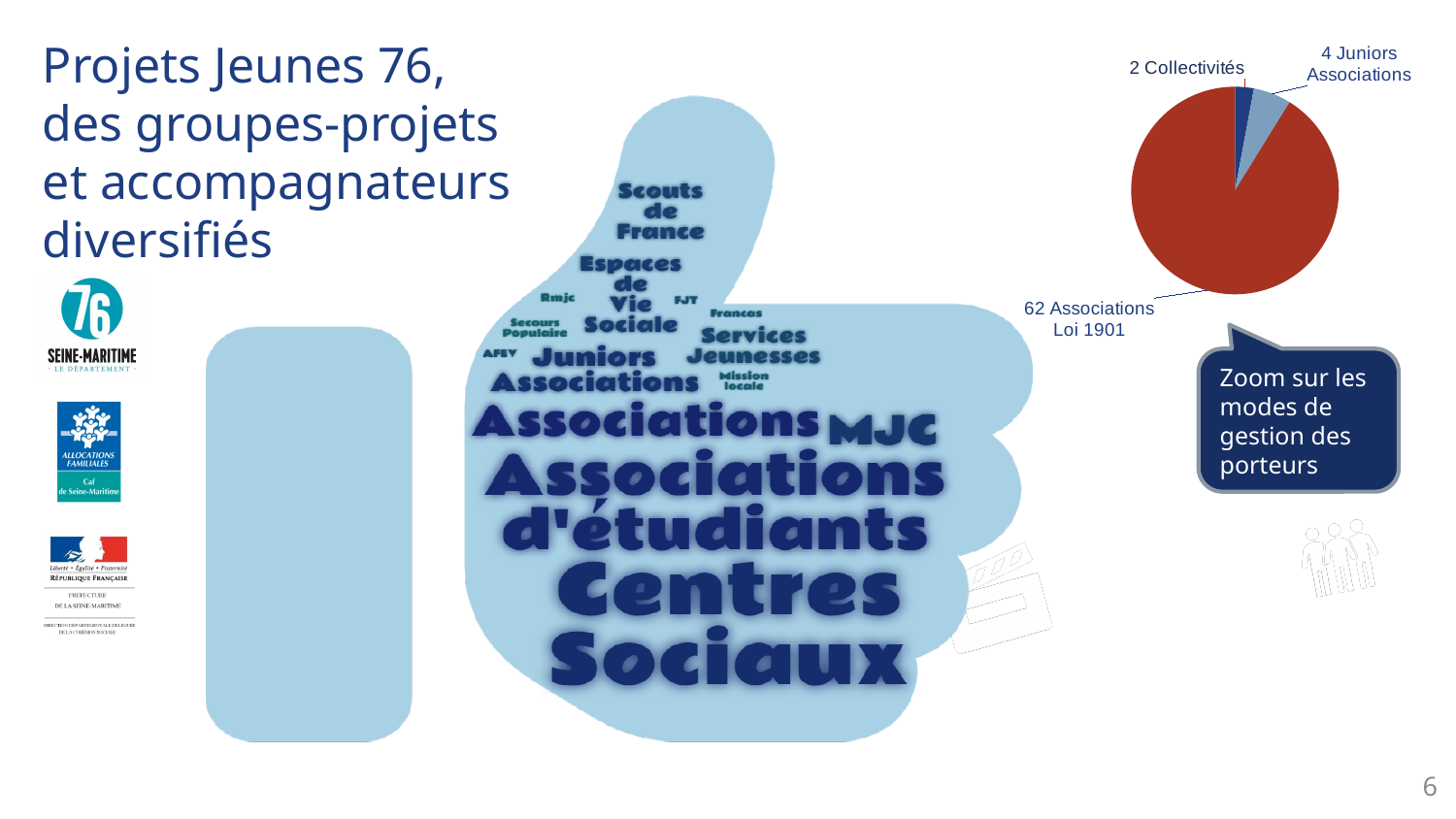
What is the difference between the number of Juniors Associations and the number of Collectivités? 2 How many Collectivités are shown in the pie chart? 2 What colour is the Associations Loi 1901 slice in the pie chart? Red Which category has the largest slice in the pie chart? Associations Loi 1901 Which category has the smallest slice in the pie chart? Collectivités Which is larger in the pie chart: Juniors Associations or Collectivités? Juniors Associations How many slices does the pie chart have? 3 What is the difference between the number of Associations Loi 1901 and the number of Juniors Associations? 58 How many Juniors Associations are shown in the pie chart? 4 What kind of chart is shown on the right of the slide? Pie chart How many Associations Loi 1901 are shown in the pie chart? 62 What is the total number of porteurs across all slices of the pie chart? 68